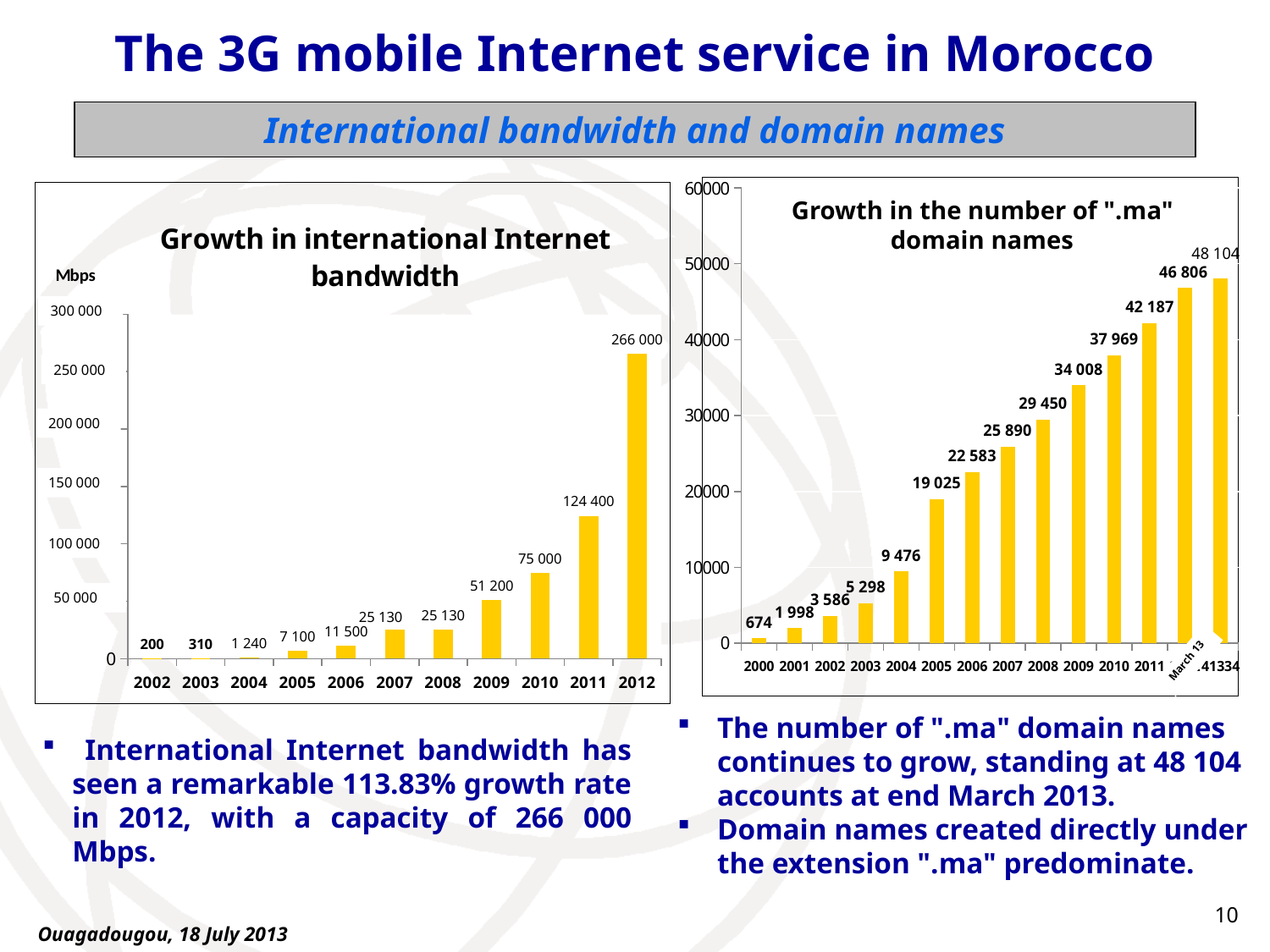
In the 'Growth in international Internet bandwidth' chart, what is the value for 2012? 266 000 In the 'Growth in international Internet bandwidth' chart, how many years are shown on the x axis? 11 In the 'Growth in international Internet bandwidth' chart, what is the difference between the values for 2012 and 2011? 141 600 In the 'Growth in the number of ".ma" domain names' chart, do the values rise or fall from 2000 to 2011? rise In the 'Growth in the number of ".ma" domain names' chart, what is the value for 2000? 674 In the 'Growth in the number of ".ma" domain names' chart, which is larger, the value for 2008 or the value for 2009? 2009 What type of chart is the 'Growth in the number of ".ma" domain names' chart? bar chart In the 'Growth in the number of ".ma" domain names' chart, what is the value for 2005? 19 025 In the 'Growth in international Internet bandwidth' chart, what unit is shown on the vertical axis? Mbps In the 'Growth in the number of ".ma" domain names' chart, what is the difference between the values for 2011 and 2010? 4 218 In the 'Growth in international Internet bandwidth' chart, what is the value for 2009? 51 200 In the 'Growth in international Internet bandwidth' chart, which year has the lowest value? 2002